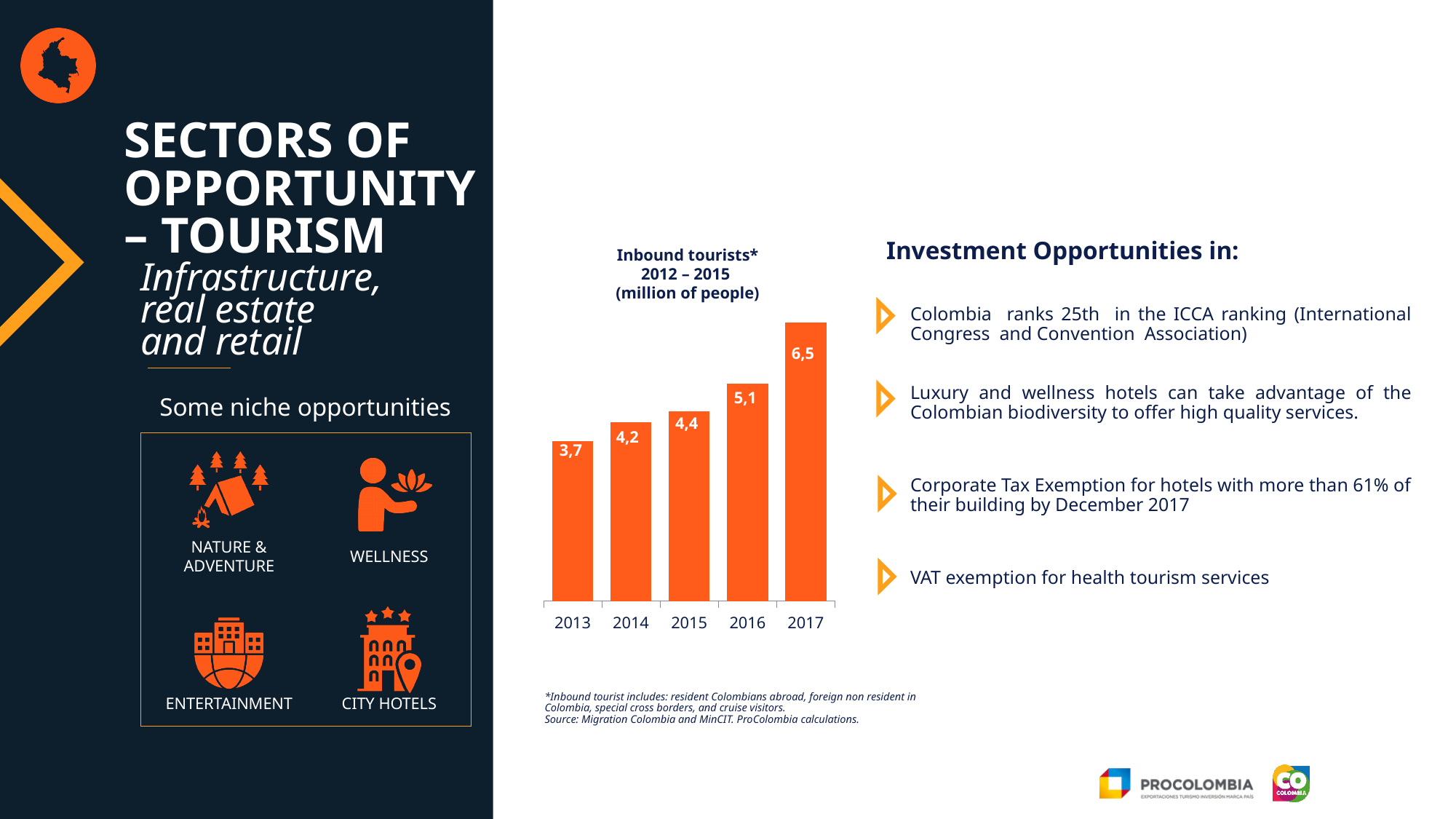
What is the difference between the values for 2016 and 2015 in the Inbound tourists chart? 0,7 Do the values in the Inbound tourists chart rise or fall from 2013 to 2017? Rise What is the value for 2016 in the Inbound tourists chart? 5,1 What is the difference between the values for 2017 and 2013 in the Inbound tourists chart? 2,8 What unit is stated in the title of the Inbound tourists chart? million of people What is the value for 2015 in the Inbound tourists chart? 4,4 How many years are shown in the Inbound tourists chart? 5 What is the value for 2013 in the Inbound tourists chart? 3,7 Which is larger in the Inbound tourists chart, the value for 2014 or the value for 2016? 2016 What kind of chart is the Inbound tourists chart? Bar chart Which year has the highest value in the Inbound tourists chart? 2017 Which year has the lowest value in the Inbound tourists chart? 2013